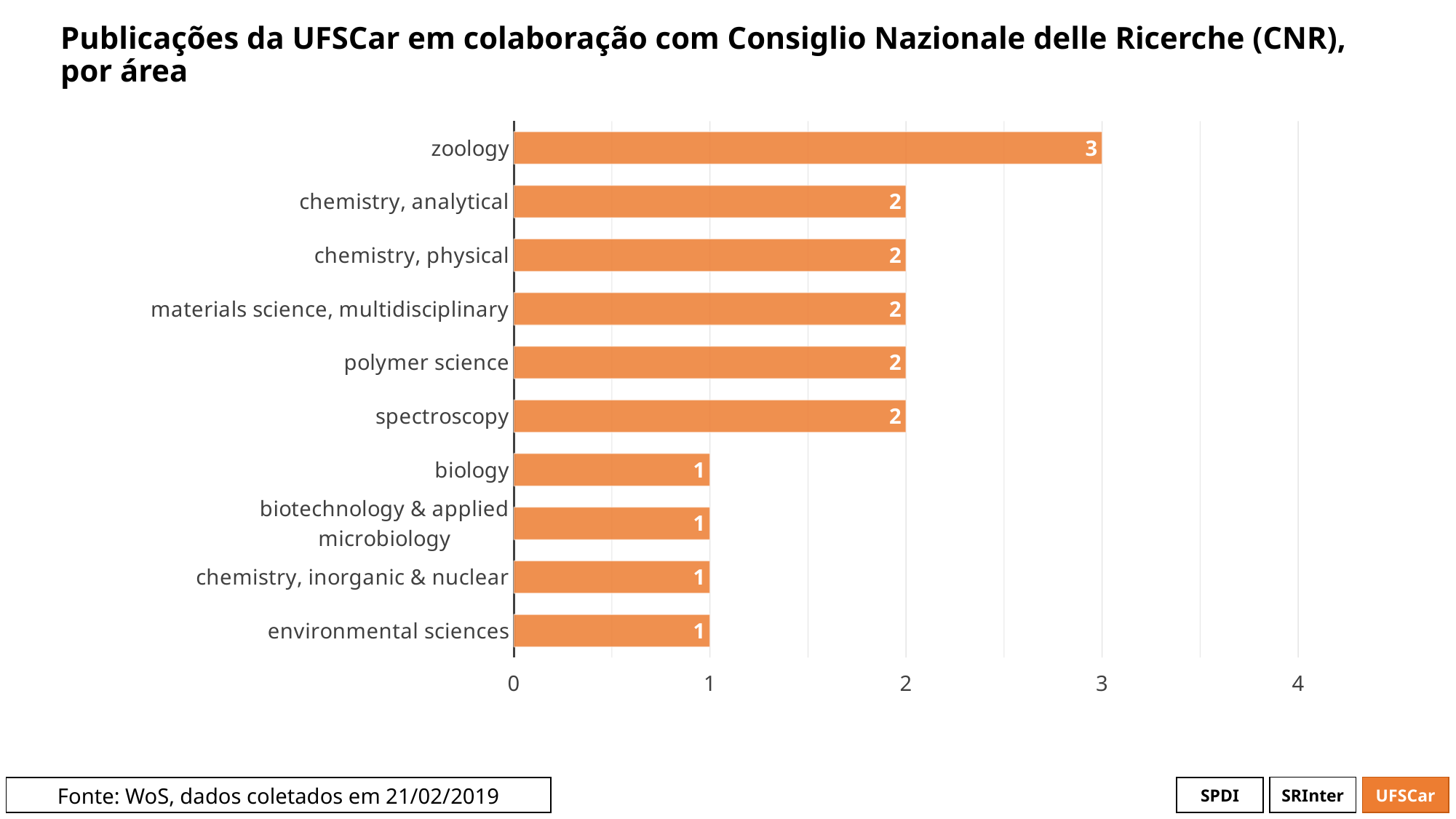
Which area has the highest value? zoology What is the value for environmental sciences? 1 How many areas are shown in the chart? 10 What is the difference between the values for zoology and spectroscopy? 1 What is the data source cited on the slide? WoS, dados coletados em 21/02/2019 What kind of chart is shown on the slide? bar chart What is the value for zoology? 3 What is the value for chemistry, inorganic & nuclear? 1 How many areas have a value of 2? 5 Which is larger, the value for materials science, multidisciplinary or the value for biotechnology & applied microbiology? materials science, multidisciplinary What is the value for polymer science? 2 What is the difference between the values for chemistry, analytical and biology? 1